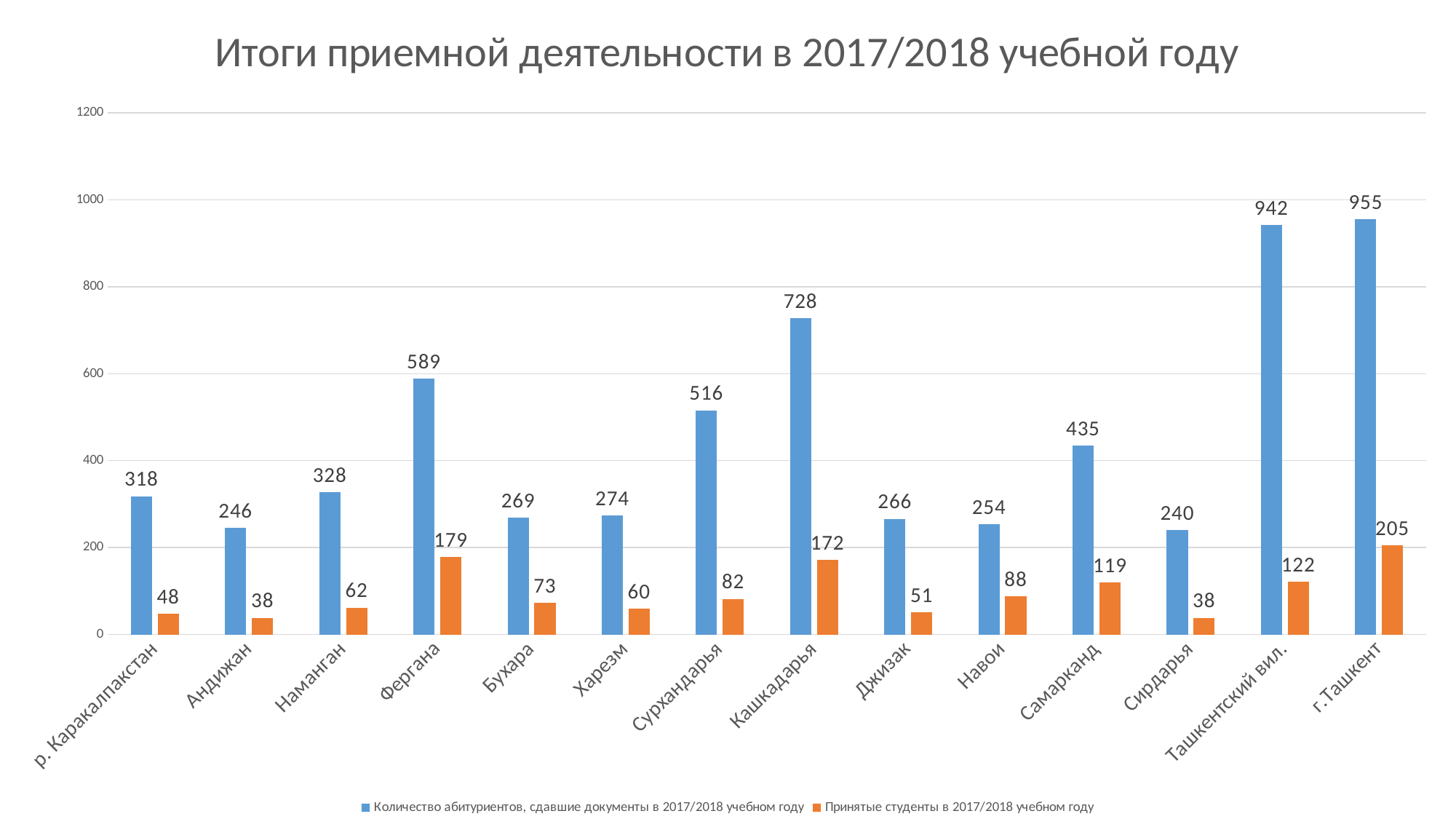
Which region has the lowest number of applicants who submitted documents? Сирдарья Which colour represents the accepted students (Принятые студенты) series? Orange How many series does the legend list? 2 What kind of chart is shown on the slide? Bar chart What is the difference between the number of applicants and the number of accepted students for Кашкадарья? 556 Is the number of applicants for Сурхандарья greater or less than 400? greater What is the title of the chart? Итоги приемной деятельности в 2017/2018 учебной году How many regions are shown on the x axis? 14 Which region has more accepted students, Самарканд or Ташкентский вил.? Ташкентский вил. Which region has the highest number of applicants who submitted documents? г.Ташкент How many accepted students (Принятые студенты) are shown for г.Ташкент? 205 What is the number of applicants who submitted documents (Количество абитуриентов, сдавшие документы) for Фергана? 589